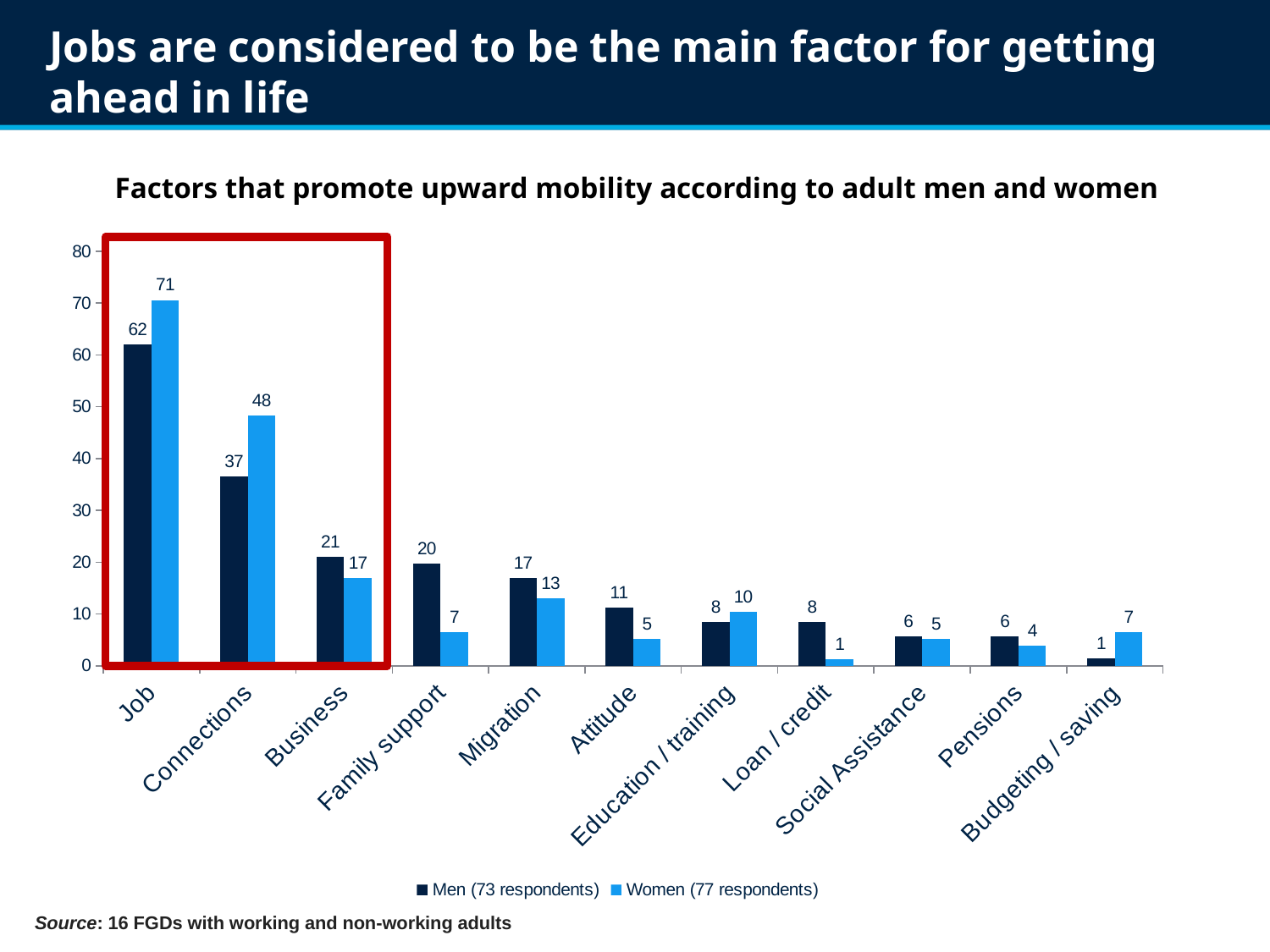
What is the title of the chart? Factors that promote upward mobility according to adult men and women How many categories are shown on the x axis? 11 Which category has the lowest value for Women? Loan / credit What kind of chart is shown? bar chart What is the value for Men for Connections? 37 What is the value for Men for Family support? 20 Is the value for Women for Connections greater or less than 40? greater Which category has the highest value for Men? Job What is the value for Women for Job? 71 Which is larger for Business, the Men value or the Women value? Men What is the difference between the Women and Men values for Job? 9 How many series does the legend list? 2